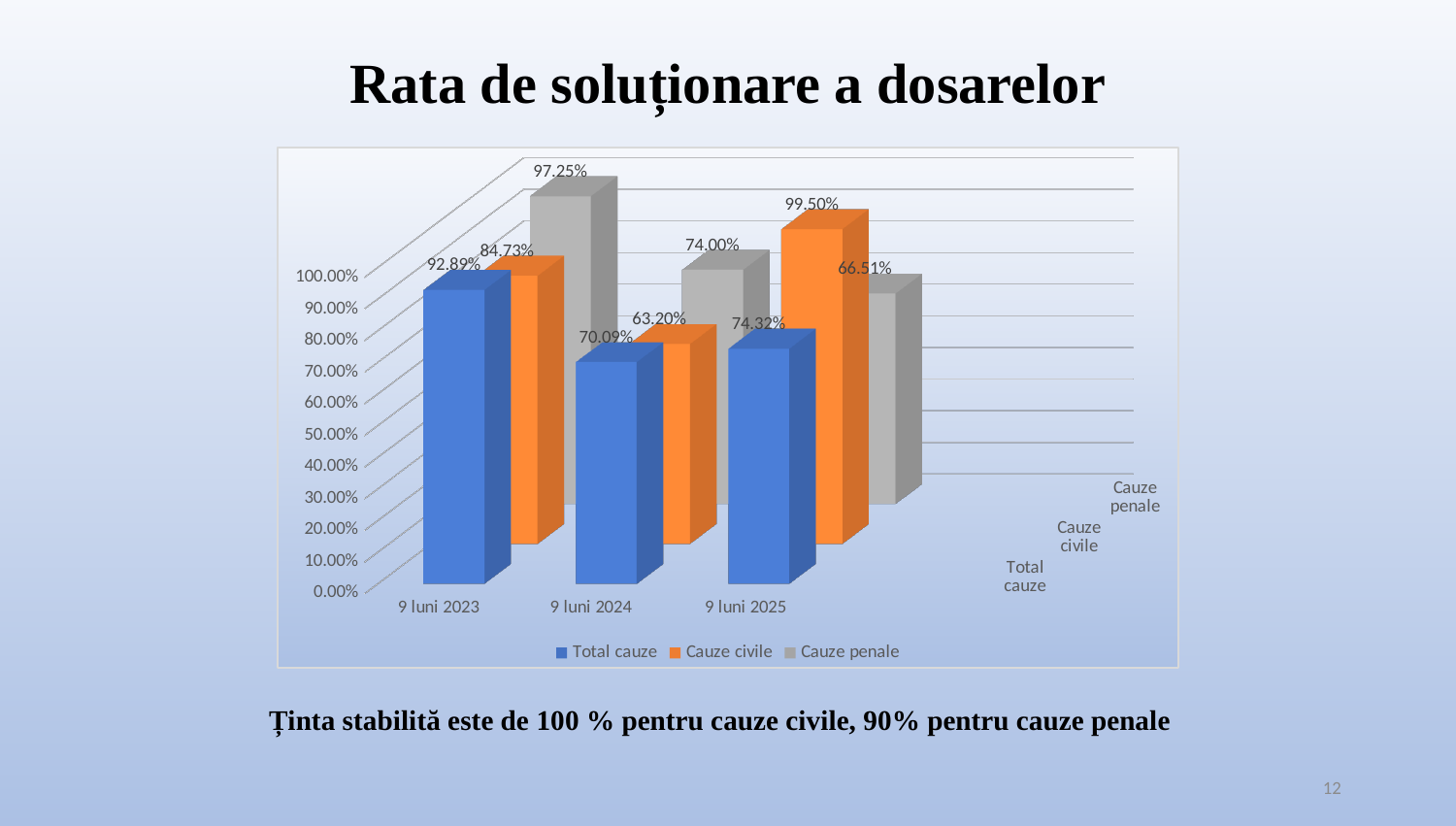
What kind of chart is shown? Bar chart What is the value for Cauze penale in 9 luni 2024? 74.00% What is the value for Cauze civile in 9 luni 2025? 99.50% What is the value for Total cauze in 9 luni 2023? 92.89% Which is larger in 9 luni 2025: Cauze civile or Cauze penale? Cauze civile What is the title of the slide? Rata de soluționare a dosarelor How many periods are shown on the x axis? 3 What is the value for Cauze civile in 9 luni 2024? 63.20% How many series does the legend list? 3 In which period is Cauze penale highest? 9 luni 2023 What is the difference between Cauze civile in 9 luni 2025 and Cauze civile in 9 luni 2024? 36.30% In which period is Total cauze lowest? 9 luni 2024